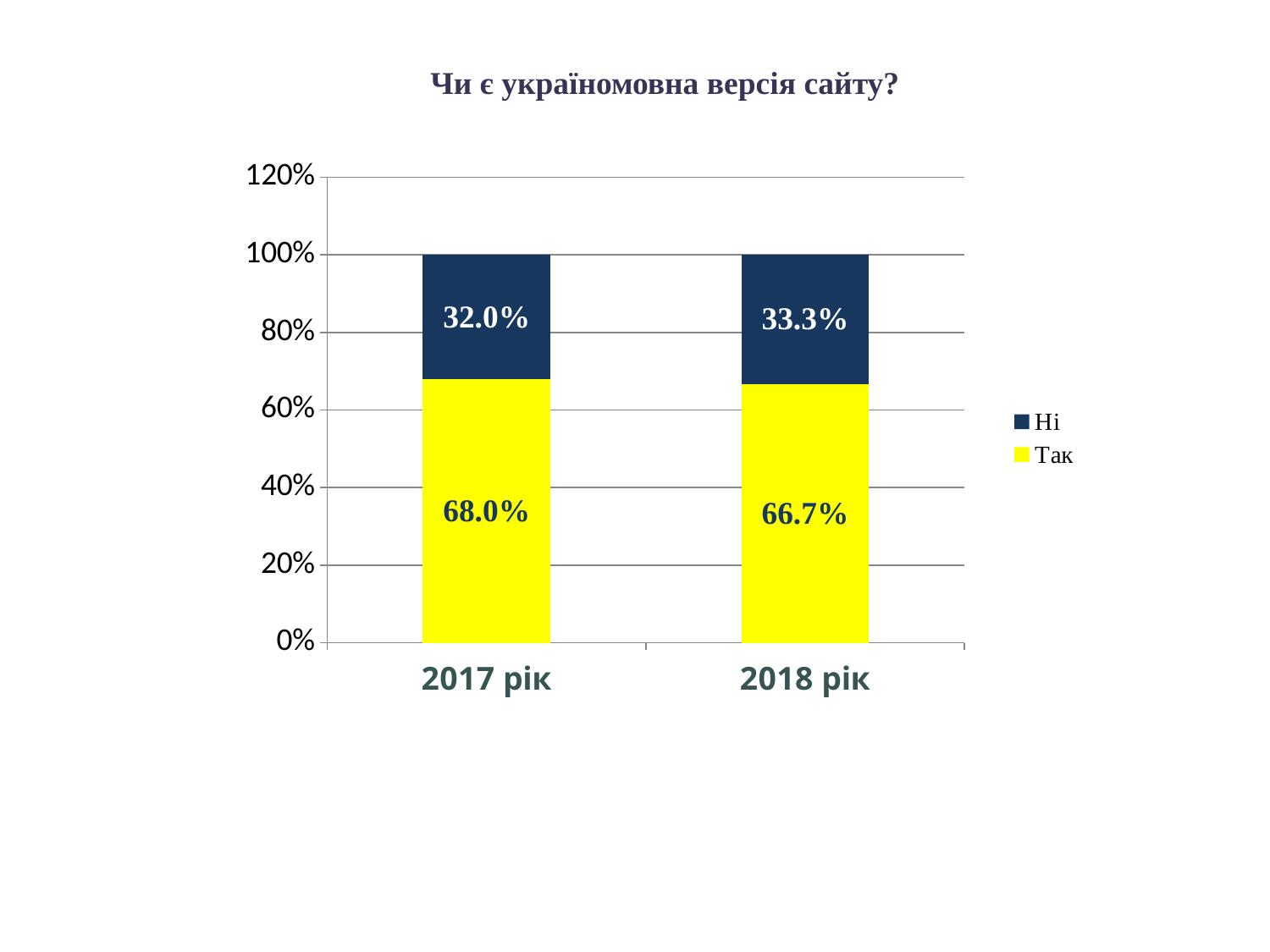
What is the value for "Ні" in 2018 рік? 33.3% What is the value for "Ні" in 2017 рік? 32.0% What is the value for "Так" in 2017 рік? 68.0% How many series does the legend list? 2 What is the difference between the "Так" values for 2017 рік and 2018 рік? 1.3% Is the "Ні" value for 2018 рік larger or smaller than the "Ні" value for 2017 рік? larger What is the value for "Так" in 2018 рік? 66.7% Which year has the lower value for "Ні"? 2017 рік What is the title of the chart? Чи є україномовна версія сайту? Which year has the higher value for "Так"? 2017 рік What kind of chart is shown on the slide? stacked bar chart How many categories are shown on the x axis? 2